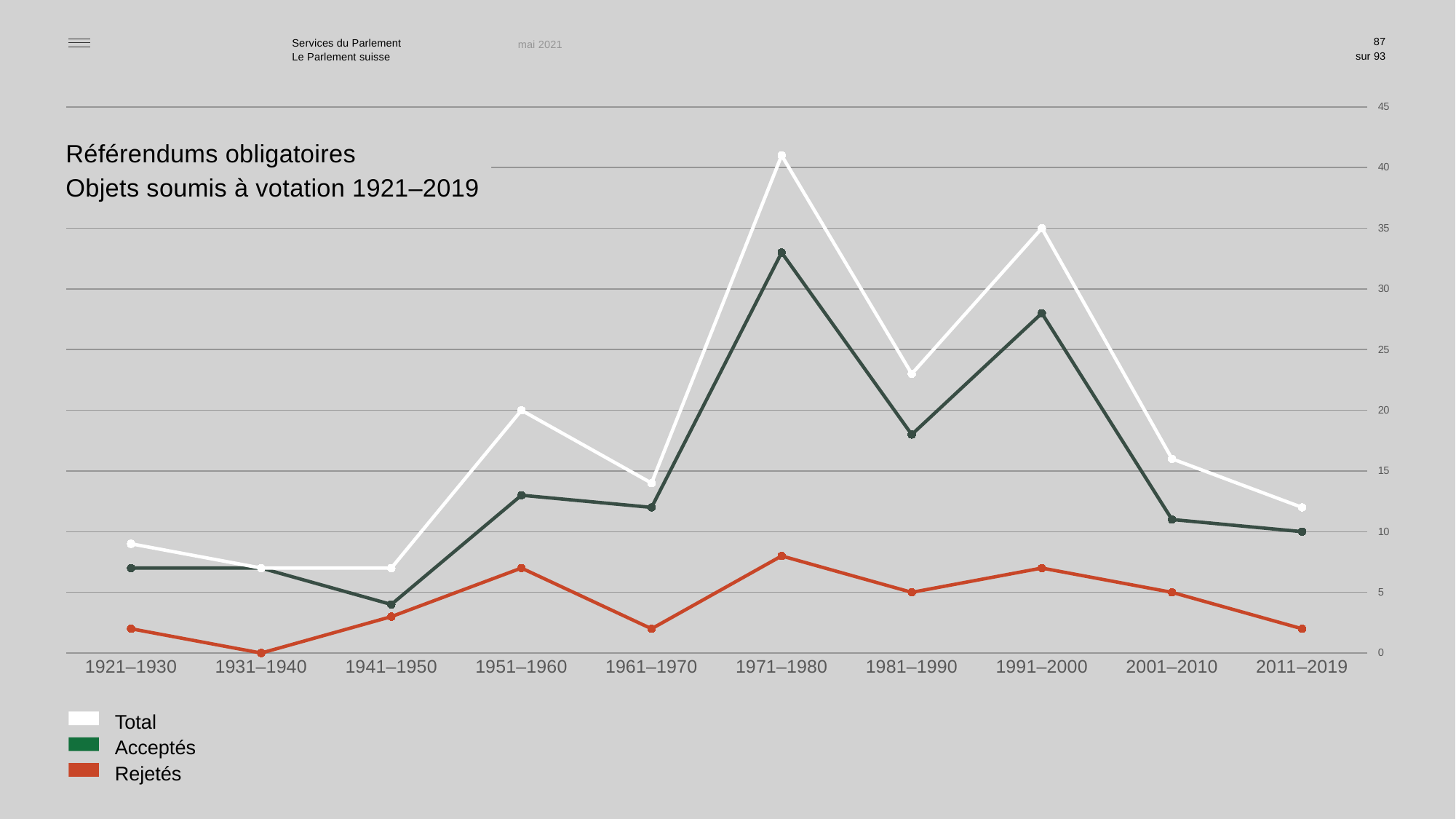
Is the Acceptés value for 1971–1980 greater or less than 30? greater In which period is the Rejetés value lowest? 1931–1940 How many series does the legend list? 3 What is the Rejetés value for 1931–1940? 0 What is the Total value for 1951–1960? 20 What is the Total value for 1991–2000? 35 Is the Total value for 1971–1980 greater or less than 40? greater What kind of chart is shown on the slide? line chart Does the Total line rise or fall from 1991–2000 to 2011–2019? fall What is the Acceptés value for 2011–2019? 10 In which period is the Total highest? 1971–1980 How many periods are shown on the x axis? 10